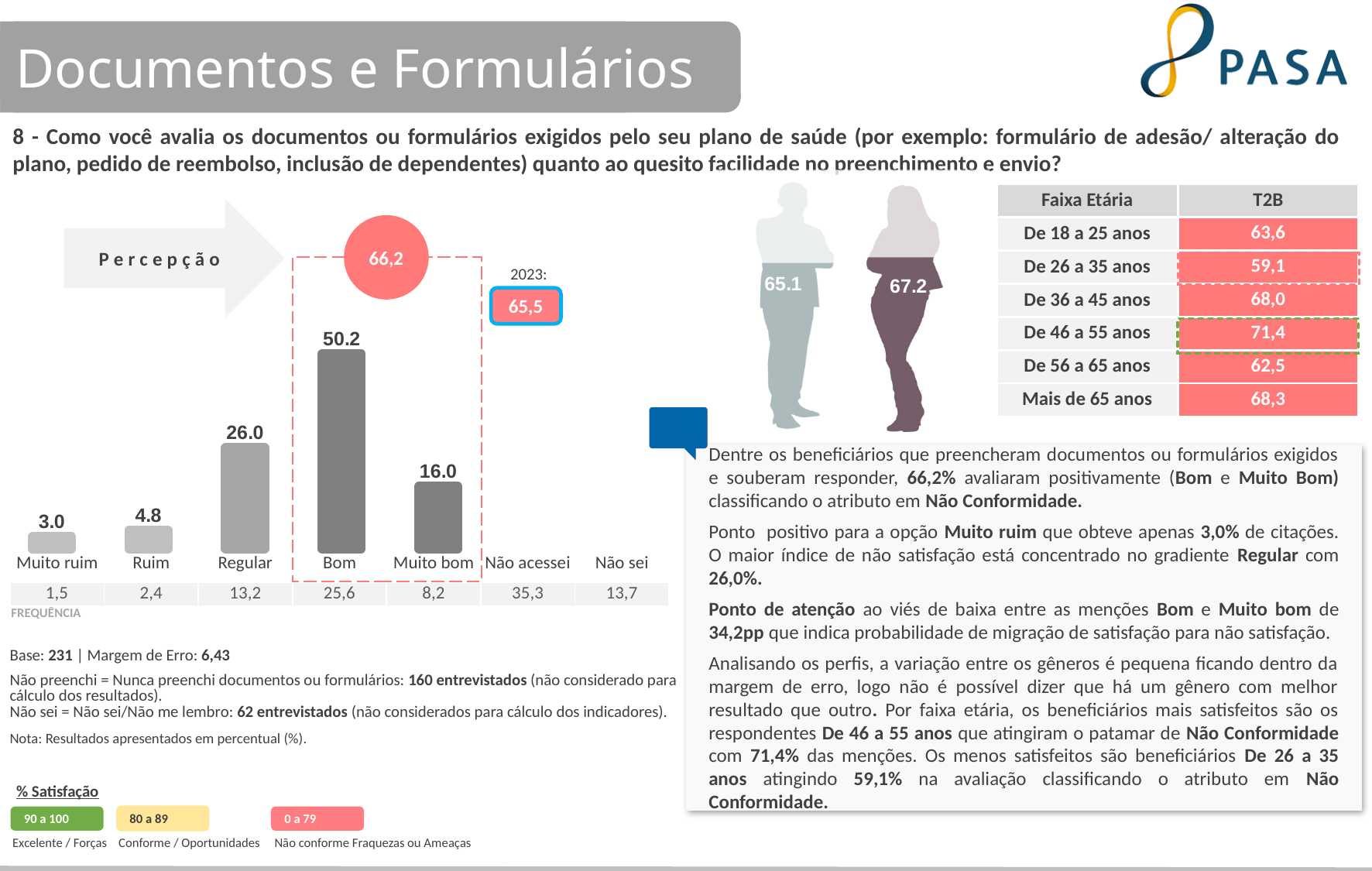
What is the value shown for the Regular bar in the bar chart? 26.0 What is the value shown for the Bom bar in the bar chart? 50.2 What is the difference between the Ruim and Muito ruim bar values in the bar chart? 1.8 What is the value shown for the Muito bom bar in the bar chart? 16.0 What value is shown in the pink circle above the dashed box grouping Bom and Muito bom? 66,2 What is the difference between the Bom and Muito bom bar values in the bar chart? 34.2 What type of chart is used to show the Muito ruim to Muito bom ratings? Bar chart What is the value shown for the Muito ruim bar in the bar chart? 3.0 Which category has the highest bar in the bar chart? Bom Which category has the lowest bar among the plotted bars in the bar chart? Muito ruim Which bar is larger in the bar chart, Regular or Muito bom? Regular What is the 2023 value shown in the box next to the bar chart? 65,5